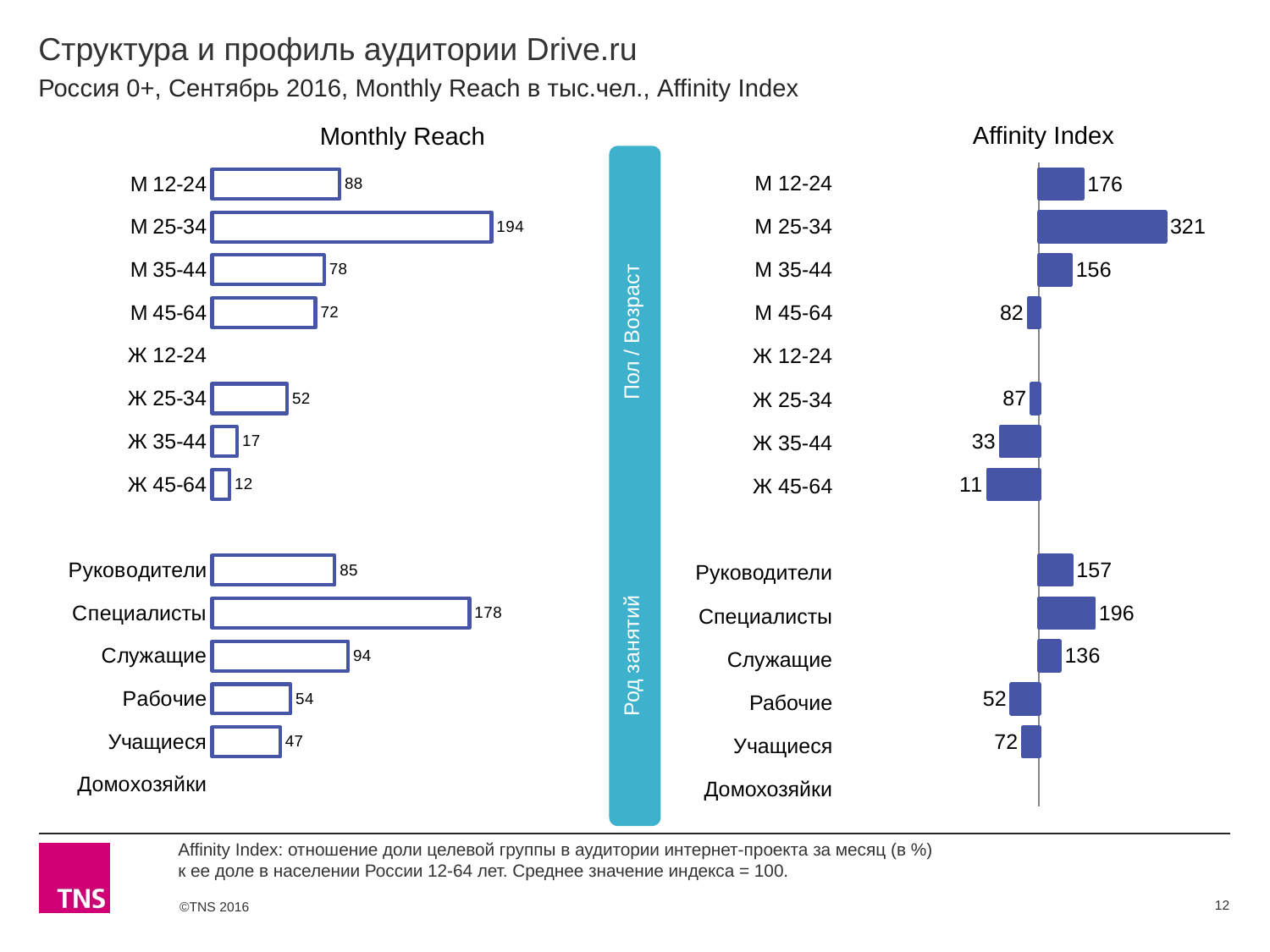
In the Affinity Index chart, which category has the lowest labelled value? Ж 45-64 In the Monthly Reach chart, which category has the lowest labelled value? Ж 45-64 In the Monthly Reach chart, what is the value for Ж 35-44? 17 In the Affinity Index chart, what is the value for Специалисты? 196 In the Affinity Index chart, which is larger: Руководители or Учащиеся? Руководители In the Affinity Index chart, what is the difference between М 12-24 and М 35-44? 20 In the Monthly Reach chart, what is the difference between Специалисты and Руководители? 93 In the Monthly Reach chart, what is the value for М 25-34? 194 In the Affinity Index chart, what is the value for Рабочие? 52 In the Monthly Reach chart, which is larger: Служащие or Рабочие? Служащие What kind of chart is the Monthly Reach chart? Bar chart In the Affinity Index chart, which category has the highest value? М 25-34